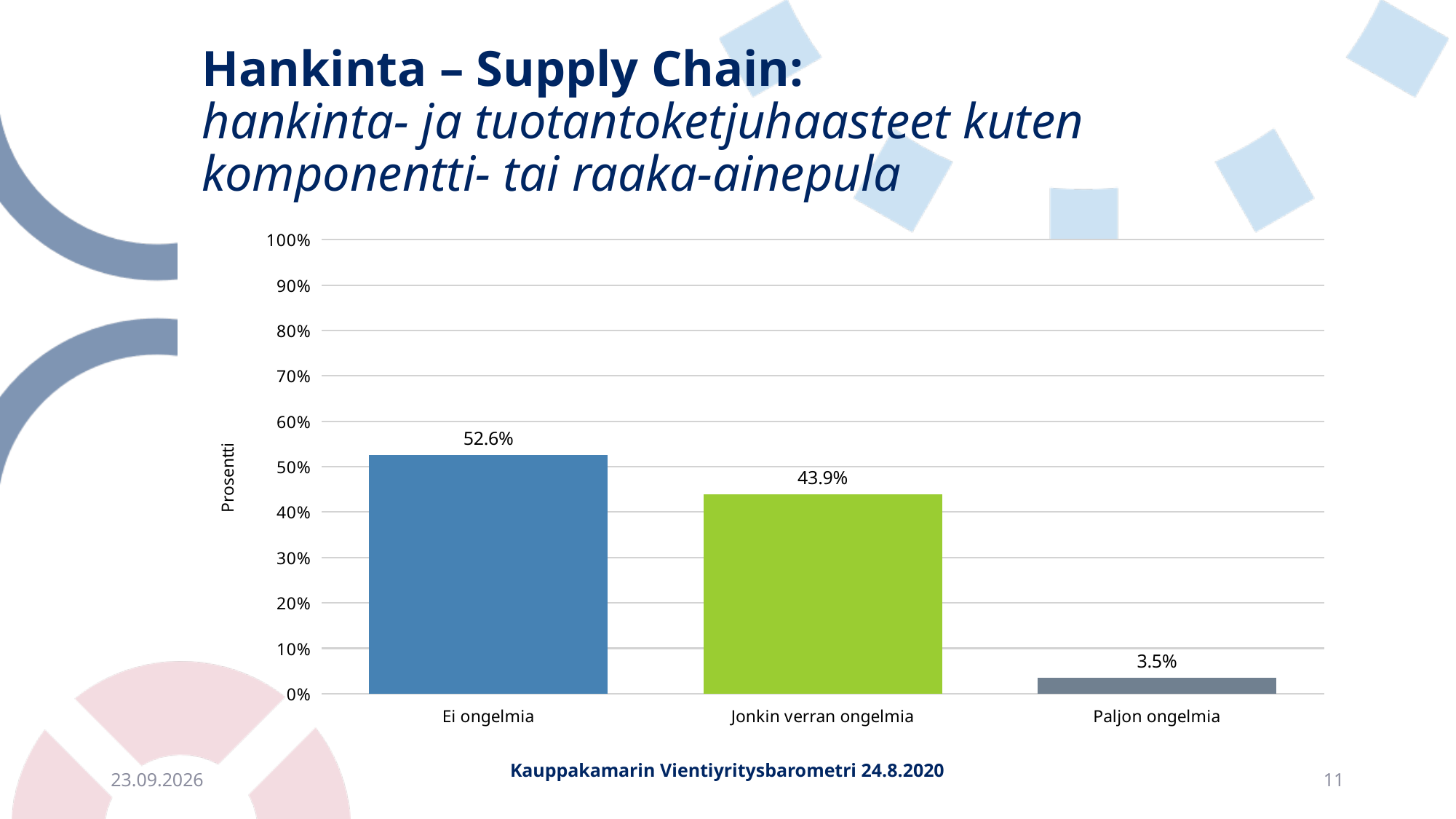
Which is larger, the value for Ei ongelmia or the value for Jonkin verran ongelmia? Ei ongelmia How many categories are shown on the x axis? 3 Is the value for Jonkin verran ongelmia greater or less than 50%? less What is the value for Jonkin verran ongelmia? 43.9% What is the difference between the values for Jonkin verran ongelmia and Paljon ongelmia? 40.4% What is the value for Paljon ongelmia? 3.5% What is the value for Ei ongelmia? 52.6% Which category has the lowest value? Paljon ongelmia What is the label of the vertical axis? Prosentti Which category has the highest value? Ei ongelmia What kind of chart is shown on the slide? bar chart What is the difference between the values for Ei ongelmia and Jonkin verran ongelmia? 8.7%